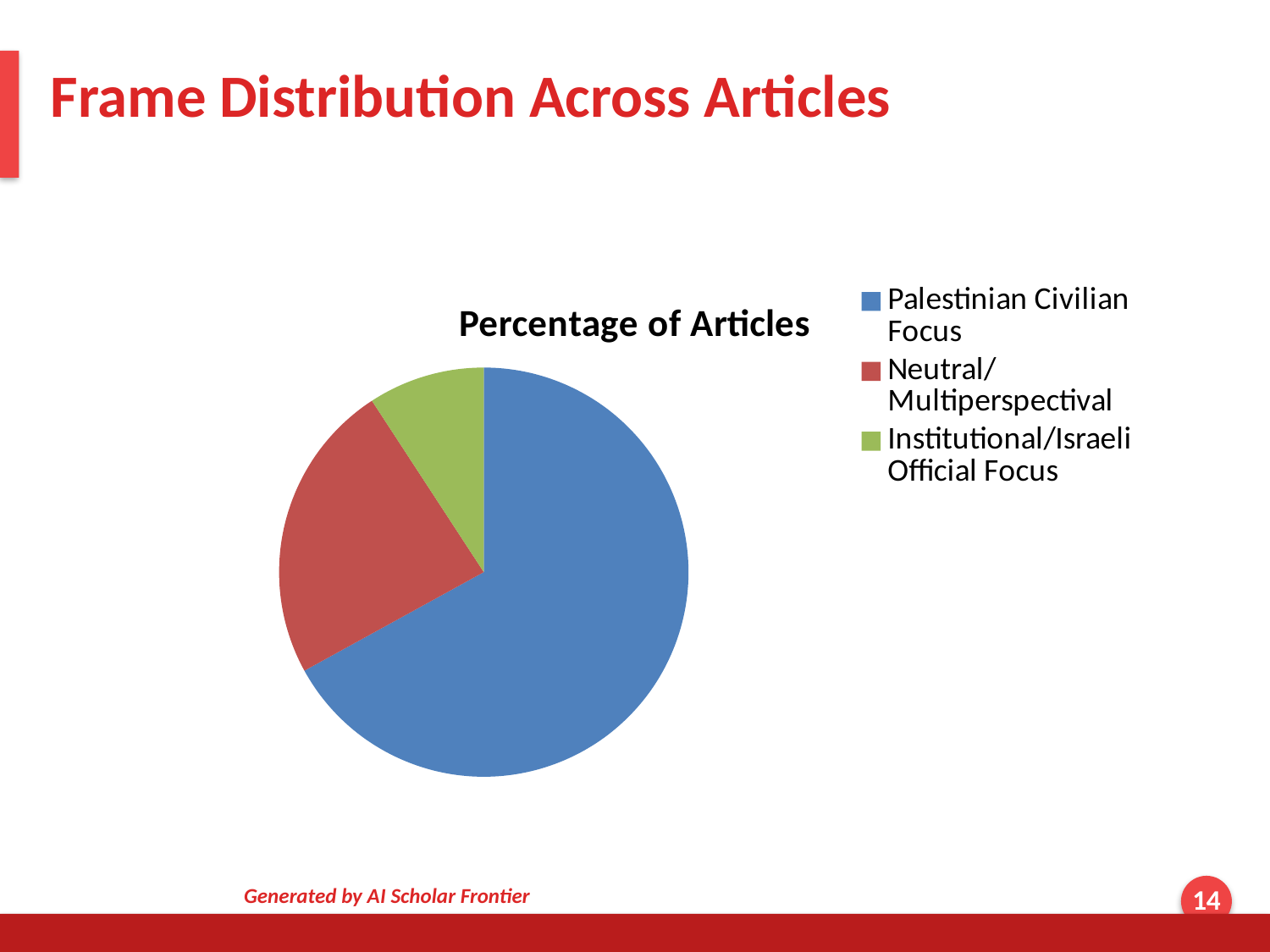
Which colour represents Institutional/Israeli Official Focus in the pie chart? green Which category has the largest slice of the pie? Palestinian Civilian Focus Which slice is larger: Neutral/Multiperspectival or Institutional/Israeli Official Focus? Neutral/Multiperspectival How many slices does the pie chart have? 3 What kind of chart is shown on the slide? pie chart How many entries does the legend list? 3 What is the title of the chart? Percentage of Articles Which category has the smallest slice of the pie? Institutional/Israeli Official Focus Which slice is larger: Palestinian Civilian Focus or Neutral/Multiperspectival? Palestinian Civilian Focus